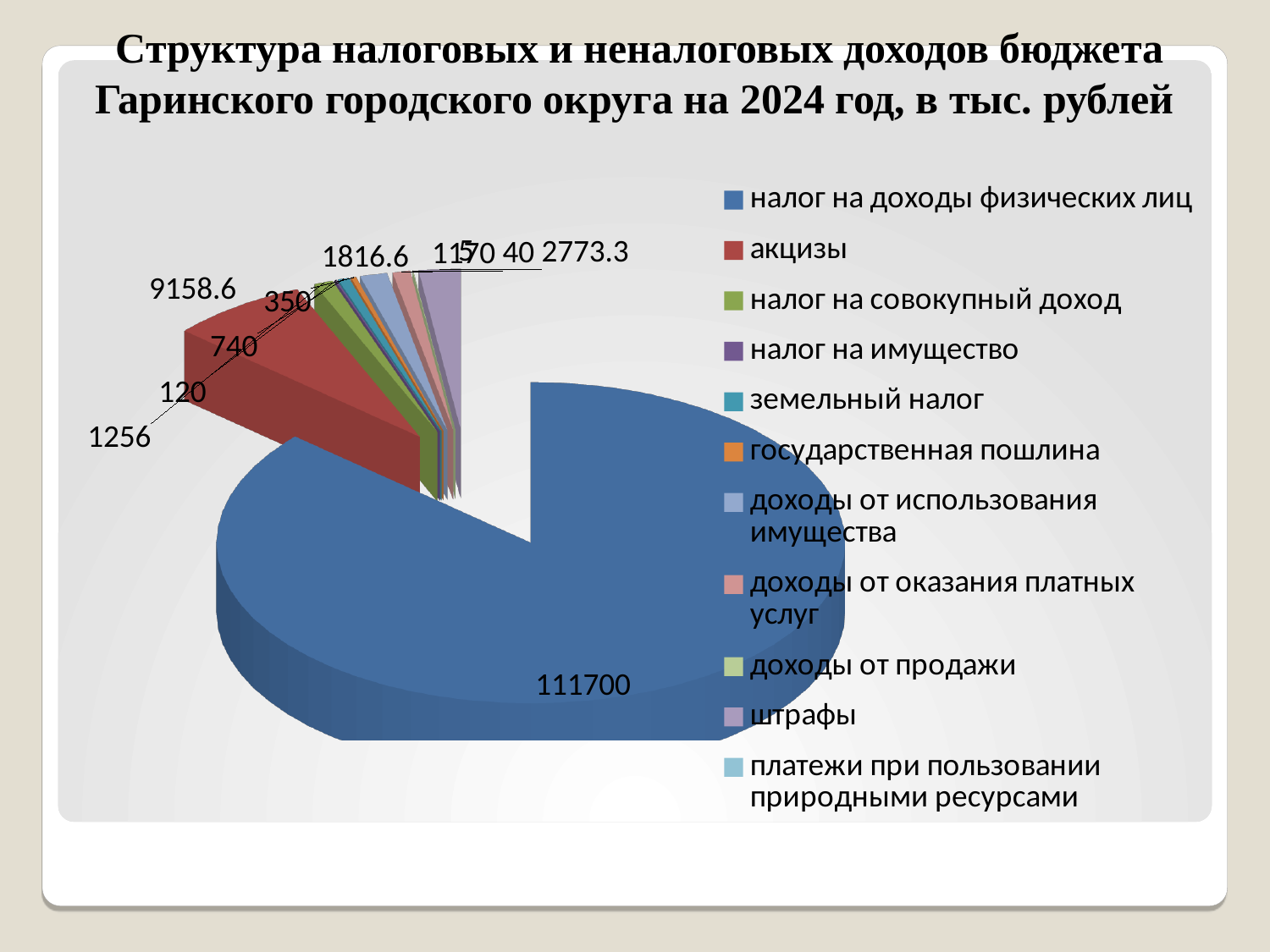
What colour is the slice for налог на доходы физических лиц? blue What is the value for налог на доходы физических лиц? 111700 Which category has the largest slice of the pie? налог на доходы физических лиц What is the title of the chart? Структура налоговых и неналоговых доходов бюджета Гаринского городского округа на 2024 год, в тыс. рублей What is the difference between the values for налог на доходы физических лиц and акцизы? 102541.4 Which is larger, налог на доходы физических лиц or акцизы? налог на доходы физических лиц What kind of chart is shown on the slide? pie chart How many categories does the legend list? 11 What is the value for акцизы? 9158.6